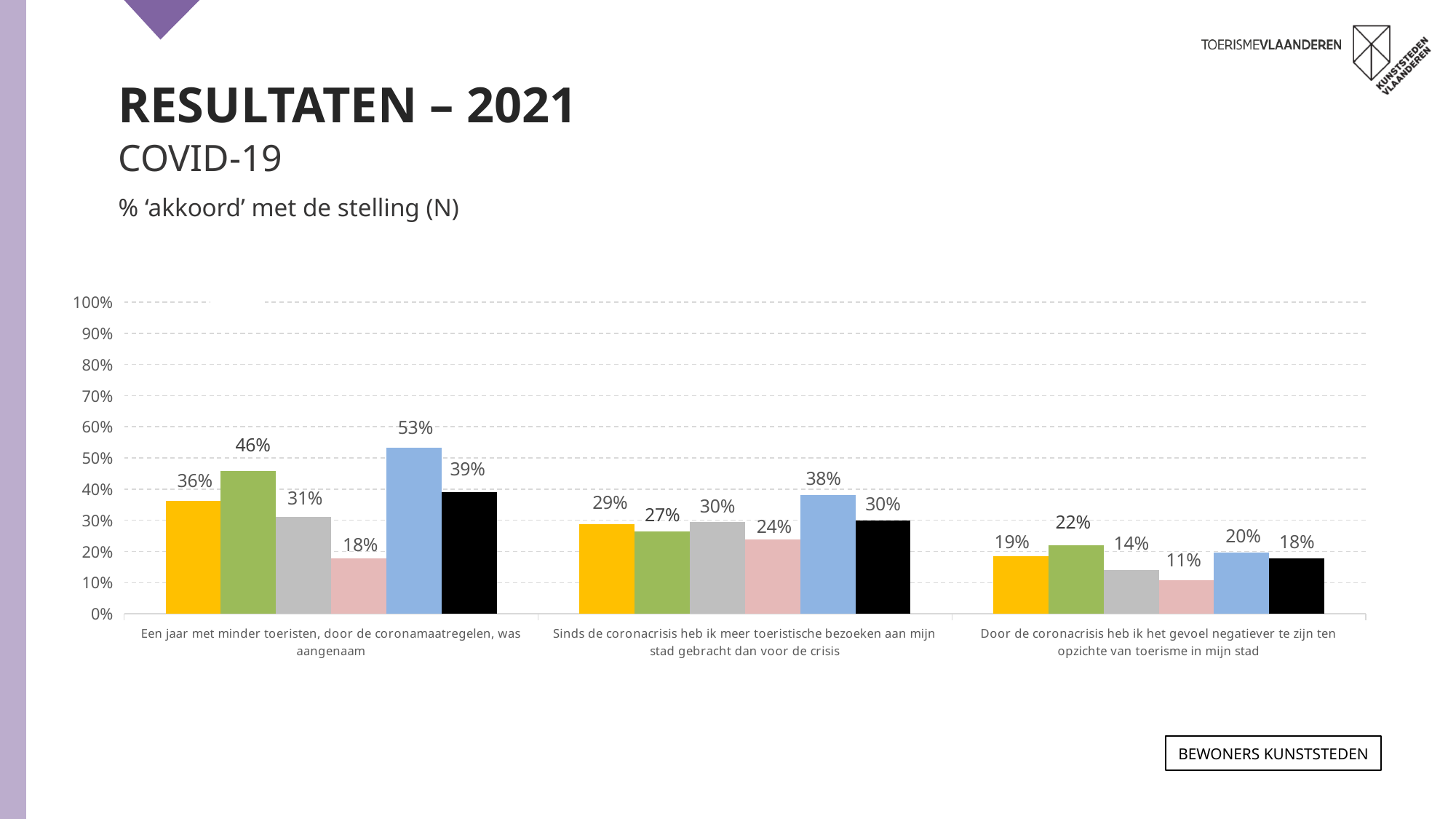
Is the value of the green bar for the statement 'Een jaar met minder toeristen, door de coronamaatregelen, was aangenaam' greater or less than 40%? greater How many statements (categories) are shown on the x axis of the chart? 3 What is the value of the black bar for the statement 'Door de coronacrisis heb ik het gevoel negatiever te zijn ten opzichte van toerisme in mijn stad'? 18% What is the difference between the blue bar and the pink bar for the statement 'Een jaar met minder toeristen, door de coronamaatregelen, was aangenaam'? 35% What is the difference between the green bar and the grey bar for the statement 'Door de coronacrisis heb ik het gevoel negatiever te zijn ten opzichte van toerisme in mijn stad'? 8% Which bar colour has the highest value for the statement 'Een jaar met minder toeristen, door de coronamaatregelen, was aangenaam'? blue What is the value of the blue bar for the statement 'Een jaar met minder toeristen, door de coronamaatregelen, was aangenaam'? 53% Which is larger for the statement 'Sinds de coronacrisis heb ik meer toeristische bezoeken aan mijn stad gebracht dan voor de crisis': the yellow bar or the blue bar? the blue bar What kind of chart is shown on the slide? bar chart What is the value of the pink bar for the statement 'Sinds de coronacrisis heb ik meer toeristische bezoeken aan mijn stad gebracht dan voor de crisis'? 24% Which bar colour has the lowest value for the statement 'Door de coronacrisis heb ik het gevoel negatiever te zijn ten opzichte van toerisme in mijn stad'? pink What is the maximum value shown on the y axis of the chart? 100%